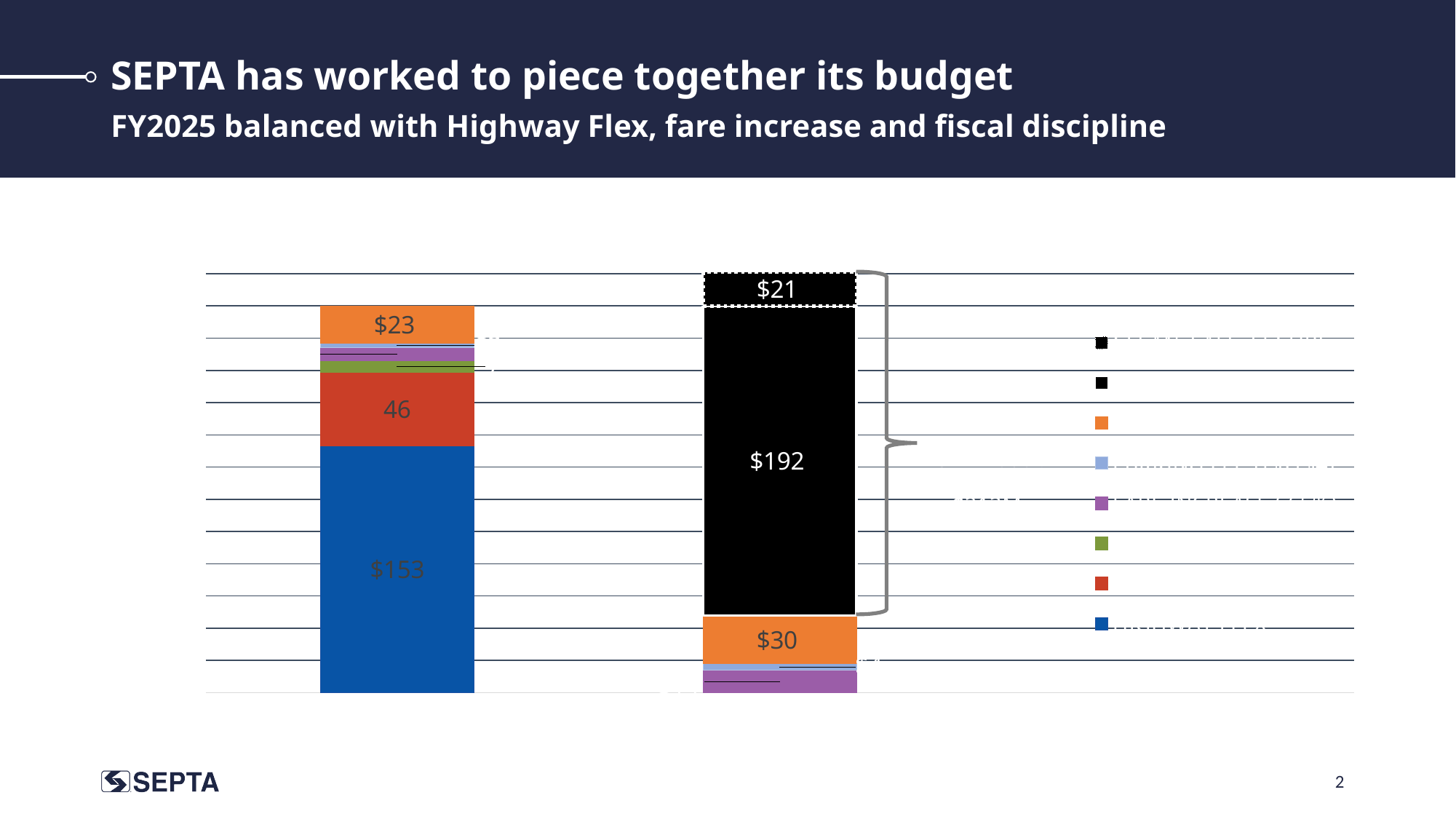
What is the value of the red segment in the left bar? 46 What is the value of the orange segment in the left bar? $23 What is the difference between the orange segment in the right bar and the orange segment in the left bar? $7 Which is larger: the blue segment in the left bar or the large black segment in the right bar? The black segment in the right bar ($192) How many series does the chart's legend list? 8 How many stacked bars are plotted in the chart? 2 What kind of chart is shown on the slide? Stacked bar chart What is the value of the blue segment in the left bar? $153 What is the value of the orange segment in the right bar? $30 What is the value of the dashed-outline black segment at the top of the right bar? $21 Which single segment in the chart is the largest? The black $192 segment in the right bar What is the value of the large black segment in the right bar? $192